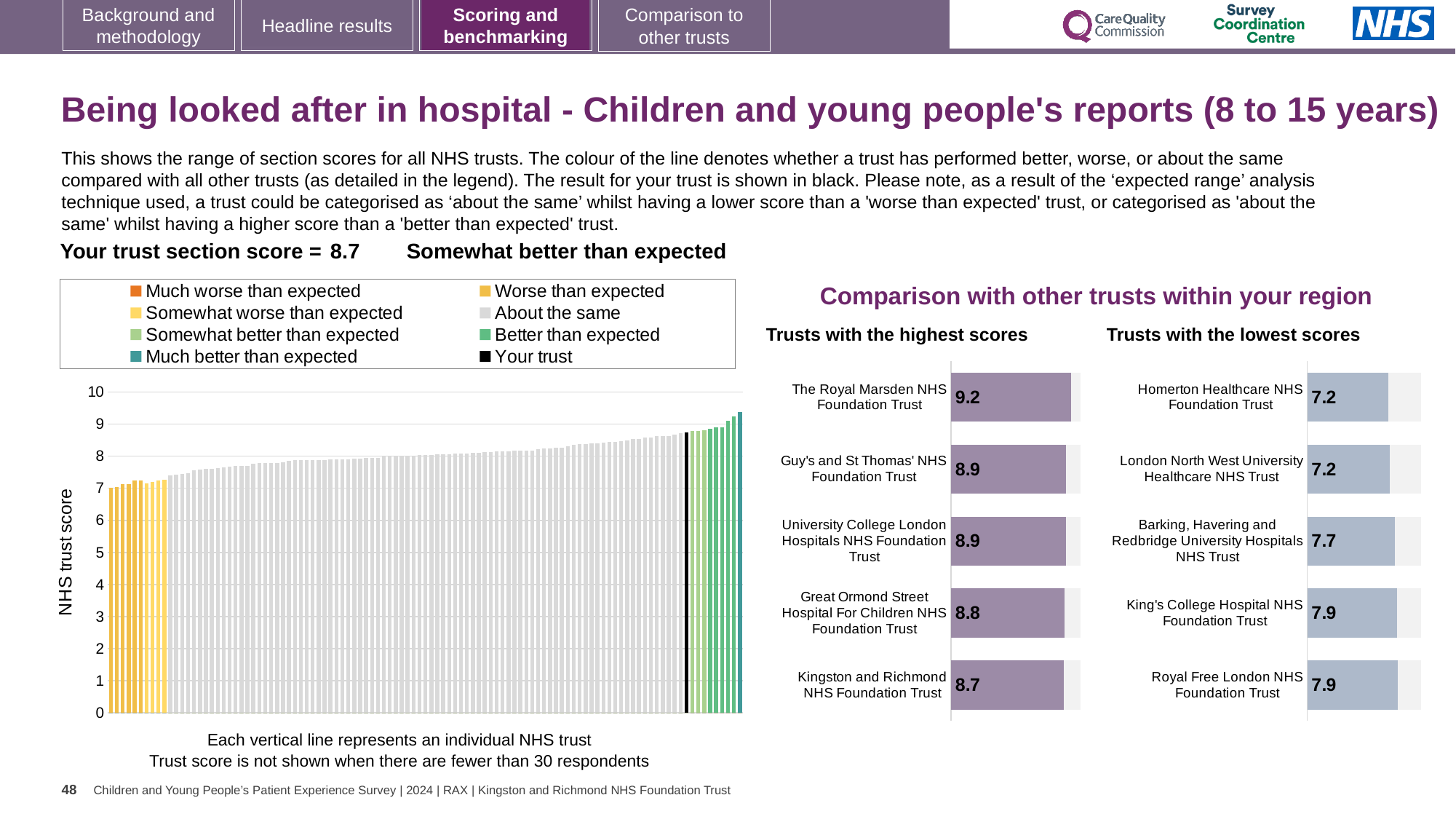
What kind of chart is the 'NHS trust score' chart on the left of the slide? Bar chart In the 'NHS trust score' chart on the left, do the bar values rise or fall from left to right? Rise In the 'Trusts with the lowest scores' chart, which has the larger score: Barking, Havering and Redbridge University Hospitals NHS Trust or King's College Hospital NHS Foundation Trust? King's College Hospital NHS Foundation Trust In the 'Trusts with the highest scores' chart, what is the difference between the scores of The Royal Marsden NHS Foundation Trust and Kingston and Richmond NHS Foundation Trust? 0.5 How many trusts are shown in the 'Trusts with the lowest scores' chart? 5 In the 'Trusts with the lowest scores' chart, what is the difference between the scores of Barking, Havering and Redbridge University Hospitals NHS Trust and Homerton Healthcare NHS Foundation Trust? 0.5 In the 'Trusts with the lowest scores' chart, what is the score for Barking, Havering and Redbridge University Hospitals NHS Trust? 7.7 In the 'Trusts with the highest scores' chart, which trust has the lowest score? Kingston and Richmond NHS Foundation Trust In the 'Trusts with the highest scores' chart, which trust has the highest score? The Royal Marsden NHS Foundation Trust In the 'NHS trust score' chart on the left, is the value of the leftmost bar greater or less than 8? less In the 'Trusts with the highest scores' chart, what is the score for The Royal Marsden NHS Foundation Trust? 9.2 How many entries does the legend above the 'NHS trust score' chart list? 8